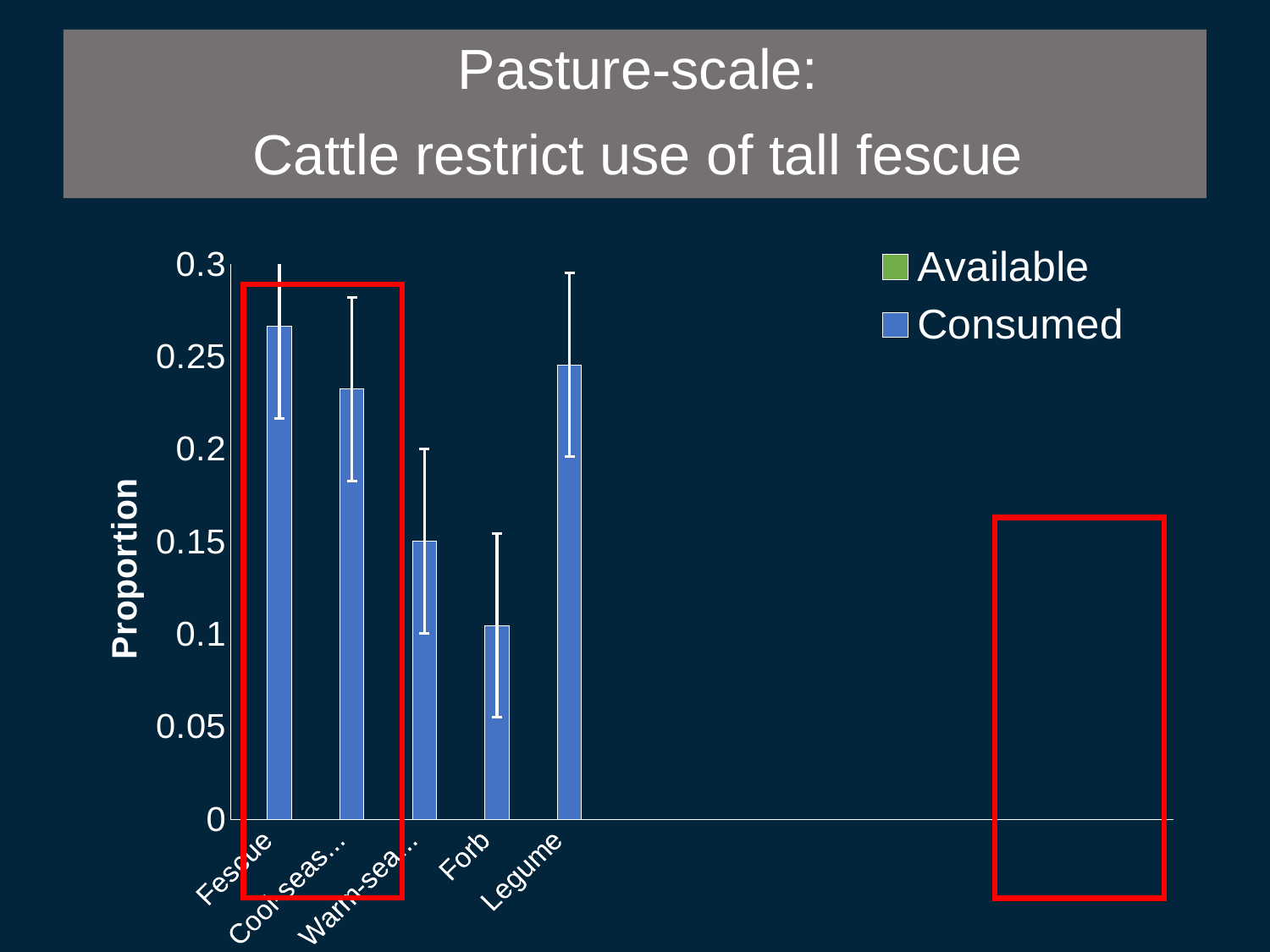
Is the value for Fescue greater or less than 0.25? greater What are the two entries listed in the chart's legend? Available and Consumed How many categories are shown on the x axis of the chart? 5 What is the label of the chart's y axis? Proportion Which is larger, the value for Fescue or the value for Forb? Fescue How many series does the chart's legend list? 2 Which category has the highest plotted bar? Fescue Is the value for Legume greater or less than 0.2? greater Which category has the lowest plotted bar? Forb What type of chart is shown on the slide? bar chart Is the value for Forb greater or less than 0.15? less Which is larger, the value for Legume or the value for Forb? Legume